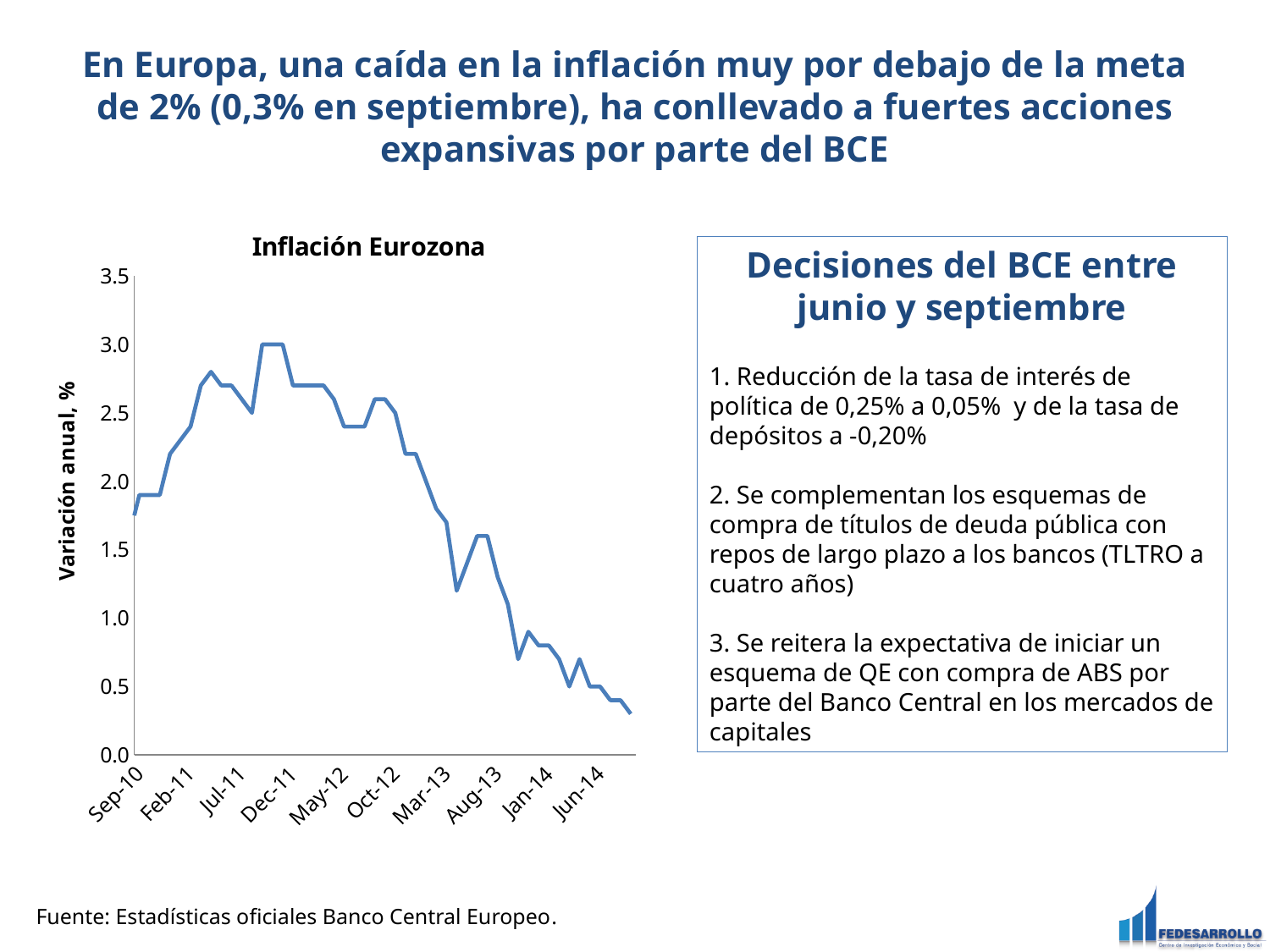
Among the labeled dates on the x axis of the 'Inflación Eurozona' chart, which has the lowest value? Jun-14 In the 'Inflación Eurozona' chart, is the value at Jan-14 greater or less than 1.0? less What kind of chart is the 'Inflación Eurozona' chart? line chart In the 'Inflación Eurozona' chart, do the values rise or fall between Dec-11 and Jun-14? fall In the 'Inflación Eurozona' chart, which is larger, the value at Jul-11 or the value at Jun-14? Jul-11 What is the title of the chart on the slide? Inflación Eurozona In the 'Inflación Eurozona' chart, which is larger, the value at Sep-10 or the value at Jan-14? Sep-10 In the 'Inflación Eurozona' chart, is the value at Sep-10 greater or less than 2.0? less In the 'Inflación Eurozona' chart, is the value at Jul-11 greater or less than 2.0? greater What is the label of the vertical axis of the 'Inflación Eurozona' chart? Variación anual, %